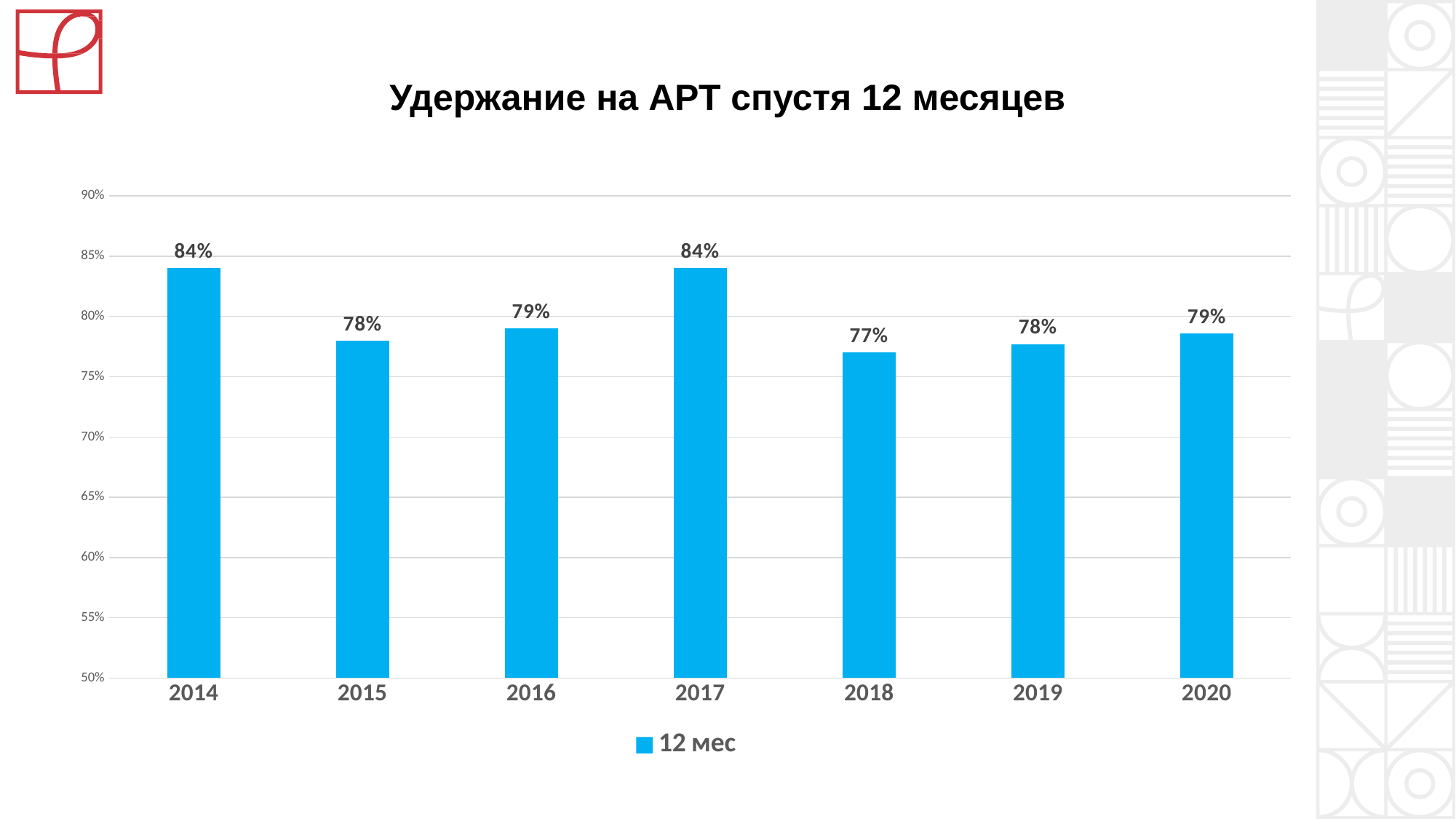
What is the difference between the values for 2014 and 2015? 6% Which is larger, the value for 2016 or the value for 2018? 2016 Is the value for 2019 greater or less than 80%? less What is the title of the chart? Удержание на АРТ спустя 12 месяцев What is the value shown for 2018? 77% How many years are shown on the x axis? 7 What is the difference between the values for 2017 and 2018? 7% What is the retention value for 2014? 84% Which year has the lowest value? 2018 What is the value shown for 2020? 79% How many series does the legend list? 1 What kind of chart is shown on the slide? bar chart